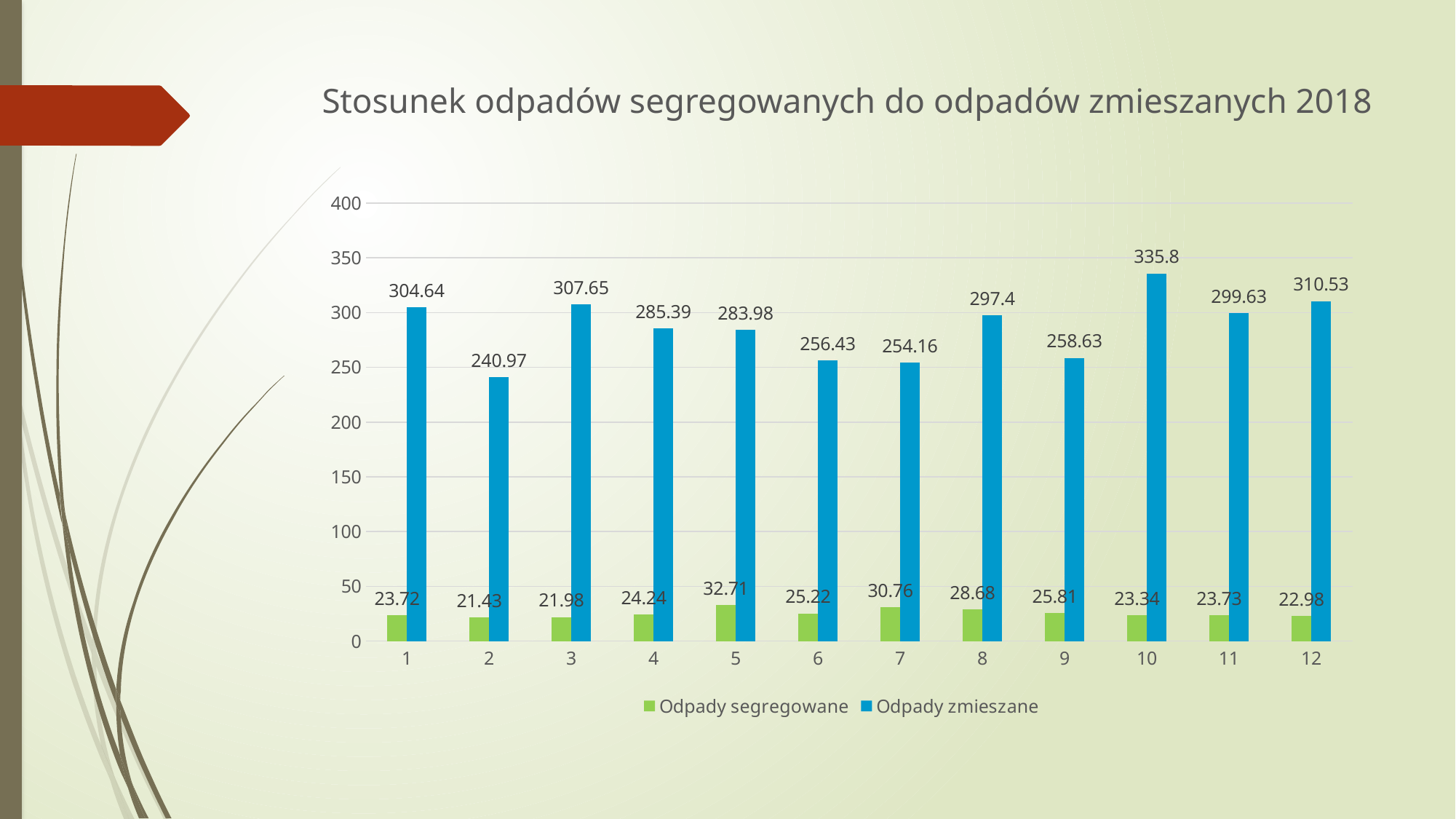
Which category has the lowest value for Odpady segregowane? 2 Which is larger: Odpady zmieszane for category 3 or for category 12? category 12 How many series does the legend list? 2 What is the difference between Odpady zmieszane and Odpady segregowane for category 1? 280.92 How many categories are shown on the x axis? 12 What is the value of Odpady zmieszane for category 10? 335.8 Which category has the lowest value for Odpady zmieszane? 2 Is the value of Odpady zmieszane for category 6 greater or less than 250? greater Which category has the highest value for Odpady zmieszane? 10 What type of chart is shown on the slide? bar chart What is the value of Odpady zmieszane for category 2? 240.97 What is the value of Odpady segregowane for category 5? 32.71